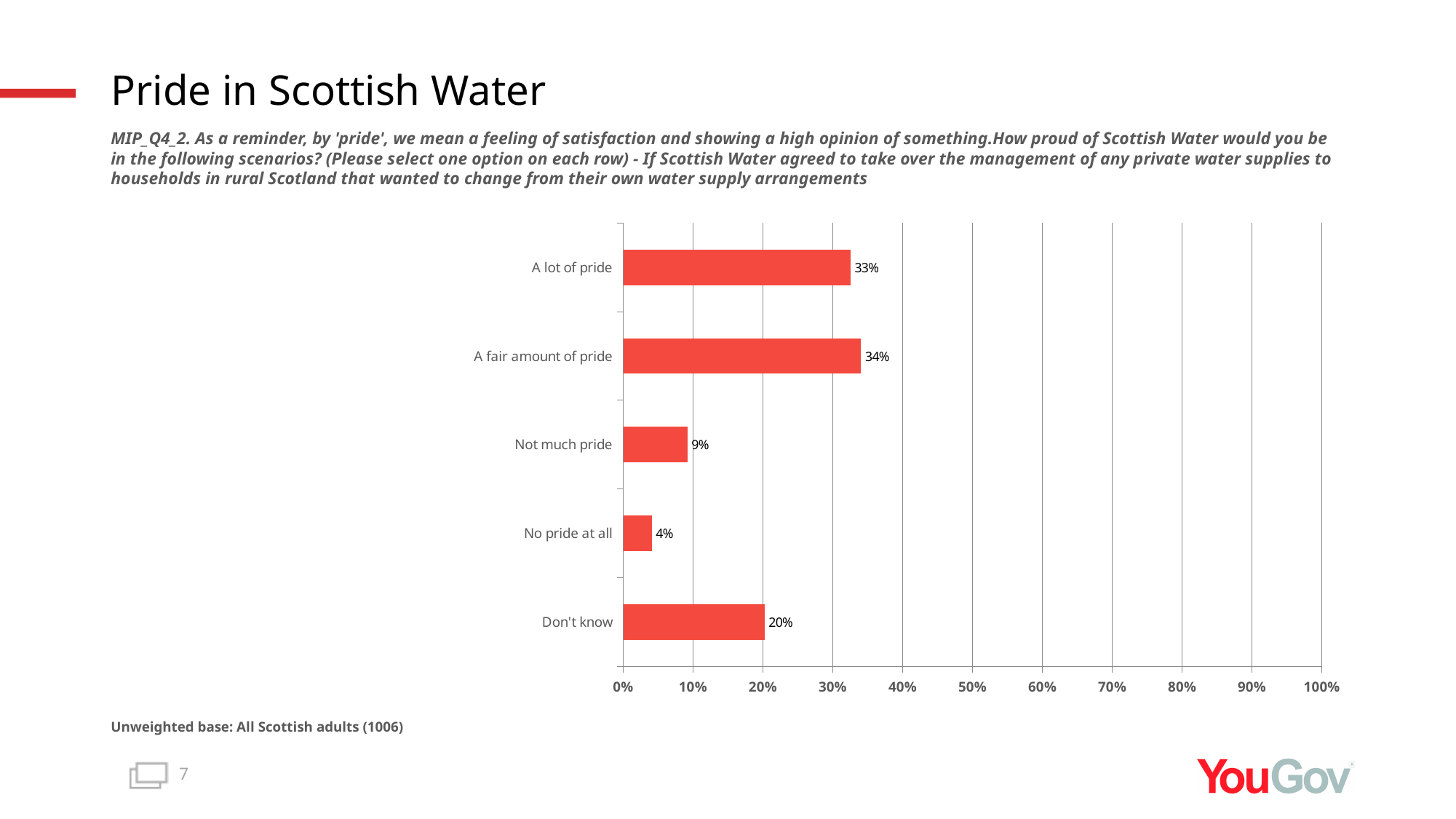
How many categories are shown on the chart? 5 Is the value for 'A lot of pride' greater or less than 30%? greater What percentage of respondents said 'No pride at all'? 4% Which category has the lowest value? No pride at all What is the unweighted base stated below the chart? All Scottish adults (1006) Which is larger: 'Not much pride' or 'Don't know'? Don't know What percentage of respondents said they would feel 'A lot of pride'? 33% What is the combined value of 'A lot of pride' and 'A fair amount of pride'? 67% What is the value shown for 'Don't know'? 20% What kind of chart is shown on the slide? Bar chart Which category has the highest value? A fair amount of pride What is the difference between 'A fair amount of pride' and 'Not much pride'? 25%